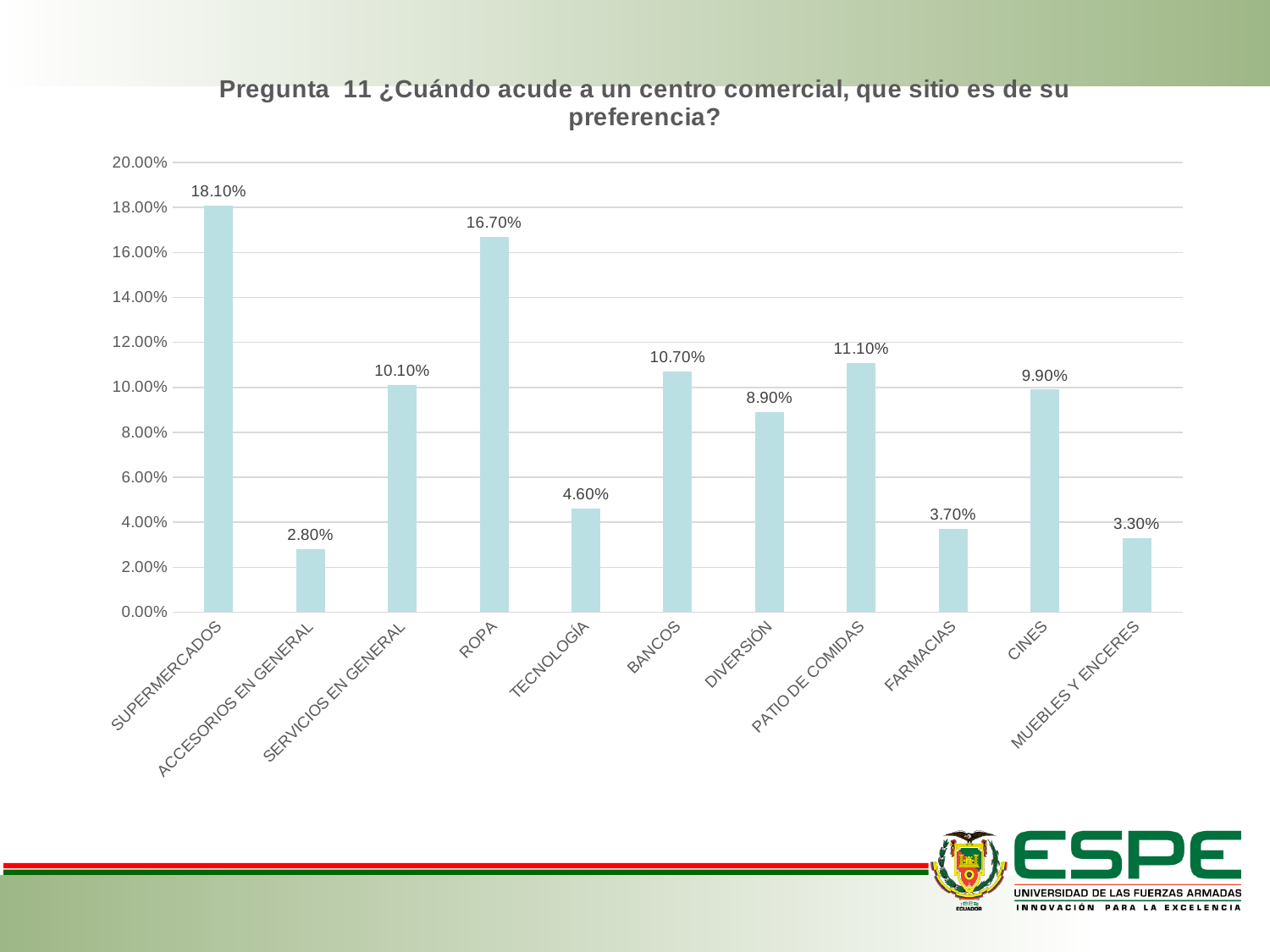
What is the value for TECNOLOGÍA? 4.60% What is the title of the chart? Pregunta 11 ¿Cuándo acude a un centro comercial, que sitio es de su preferencia? Which category has the highest value? SUPERMERCADOS What is the difference between the values for SUPERMERCADOS and ROPA? 1.40% What is the value for PATIO DE COMIDAS? 11.10% What is the value for SUPERMERCADOS? 18.10% What kind of chart is shown on the slide? bar chart Is the value for FARMACIAS greater or less than 4.00%? less What is the difference between the values for BANCOS and DIVERSIÓN? 1.80% Which category has the lowest value? ACCESORIOS EN GENERAL Which is larger, the value for CINES or the value for SERVICIOS EN GENERAL? SERVICIOS EN GENERAL How many categories are shown on the x axis? 11